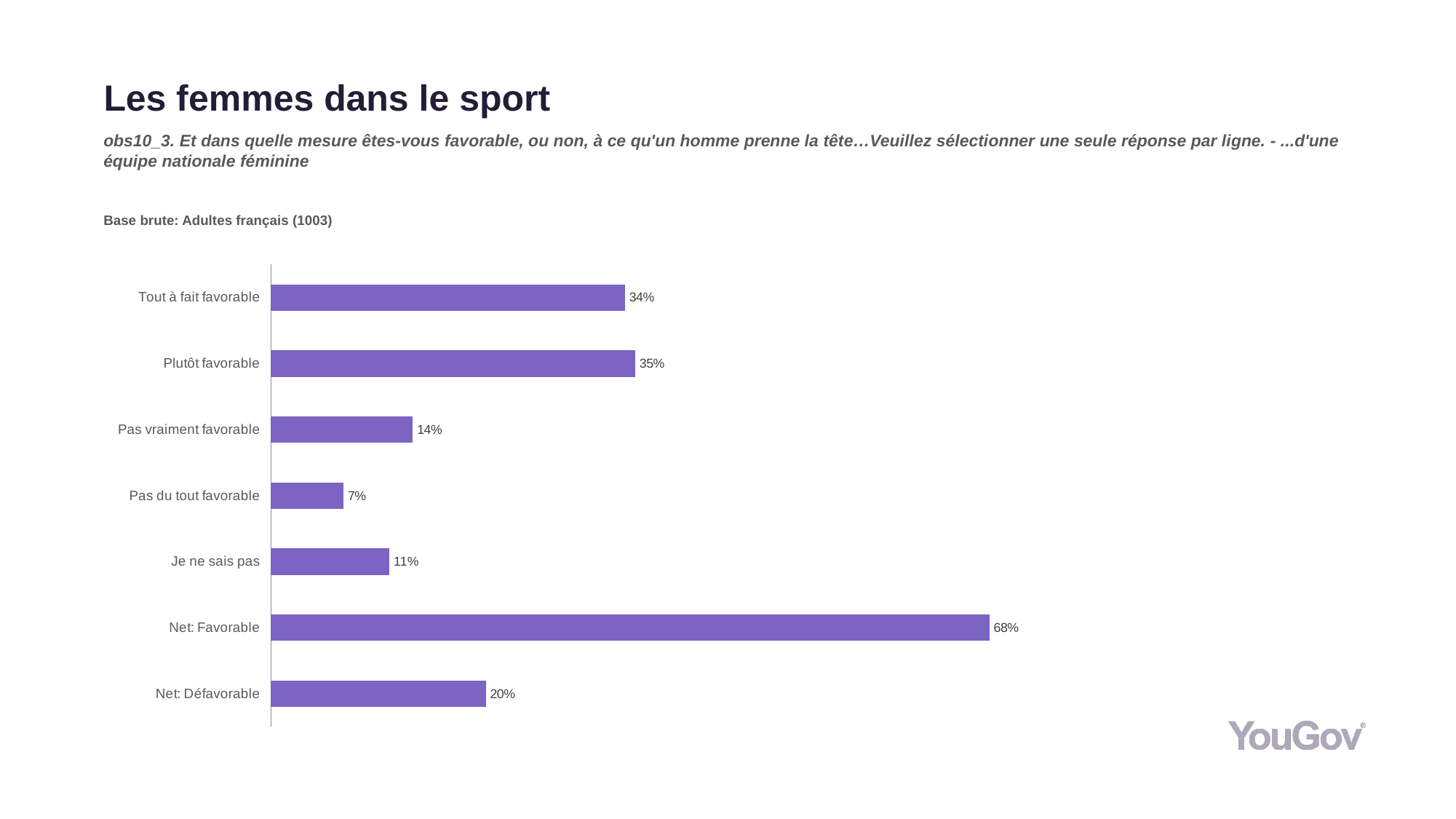
What is the value for "Plutôt favorable"? 35% What is the difference between "Net: Favorable" and "Net: Défavorable"? 48 percentage points Which is larger, the value for "Je ne sais pas" or the value for "Pas du tout favorable"? Je ne sais pas What is the difference between "Pas vraiment favorable" and "Pas du tout favorable"? 7 percentage points Which category has the highest value? Net: Favorable What is the value for "Pas vraiment favorable"? 14% What is the value for "Tout à fait favorable"? 34% Which category has the lowest value? Pas du tout favorable What is the value for "Je ne sais pas"? 11% How many categories are shown in the chart? 7 What kind of chart is shown on the slide? Bar chart What is the value for "Net: Défavorable"? 20%